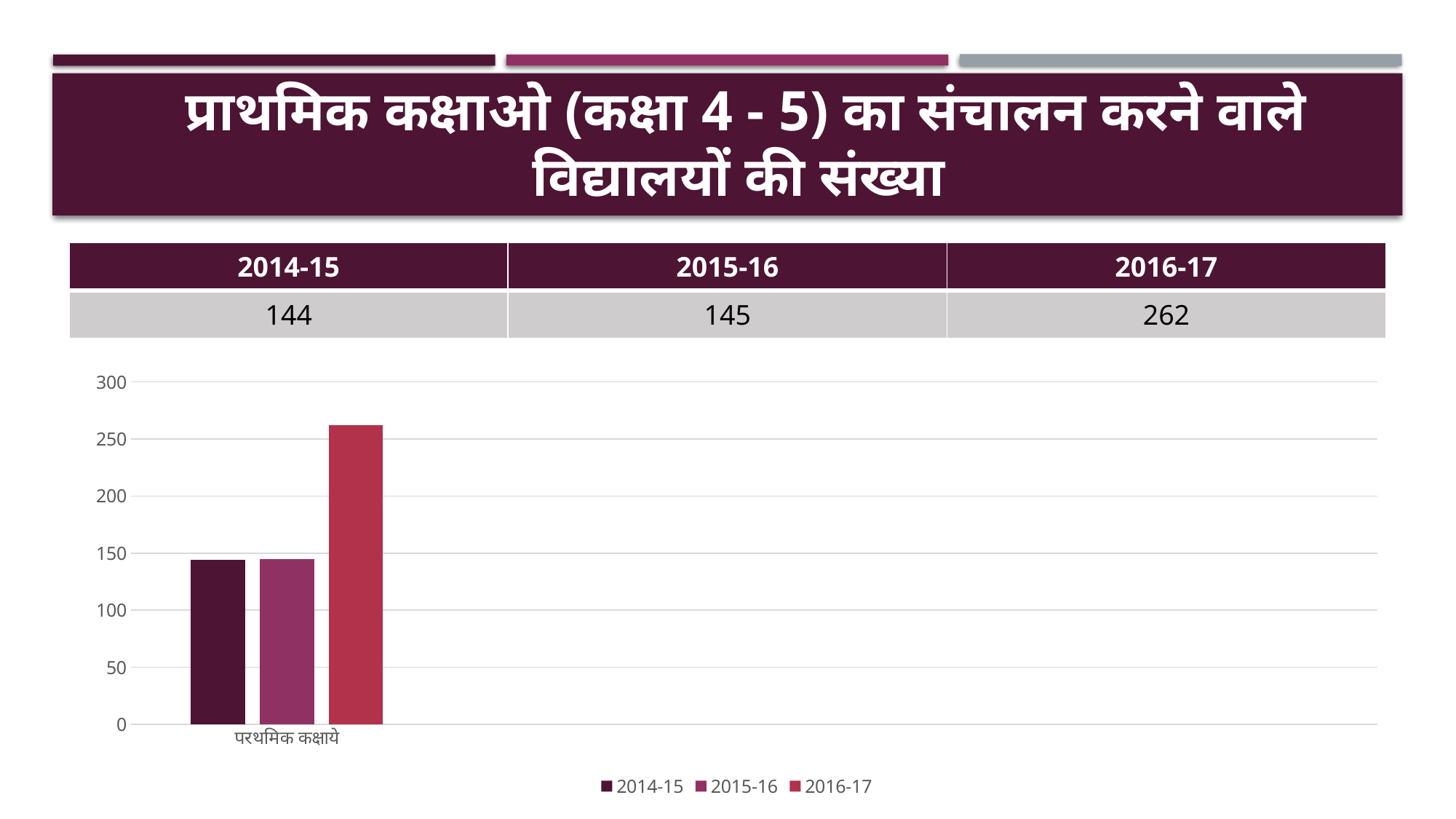
What is the label of the category on the x axis of the chart? परथमिक कक्षाये How many series does the chart legend list? 3 Which is larger, the value for 2016-17 or the value for 2015-16? 2016-17 According to the table on the slide, what is the value for 2016-17? 262 What type of chart is shown on the slide? bar chart According to the table on the slide, what is the value for 2015-16? 145 According to the table on the slide, what is the value for 2014-15? 144 What is the difference between the values for 2016-17 and 2014-15 shown in the table? 118 Is the value for 2016-17 greater or less than 250? greater Is the value for 2014-15 greater or less than 150? less How many categories are shown on the x axis of the chart? 1 Which year has the highest bar in the chart? 2016-17